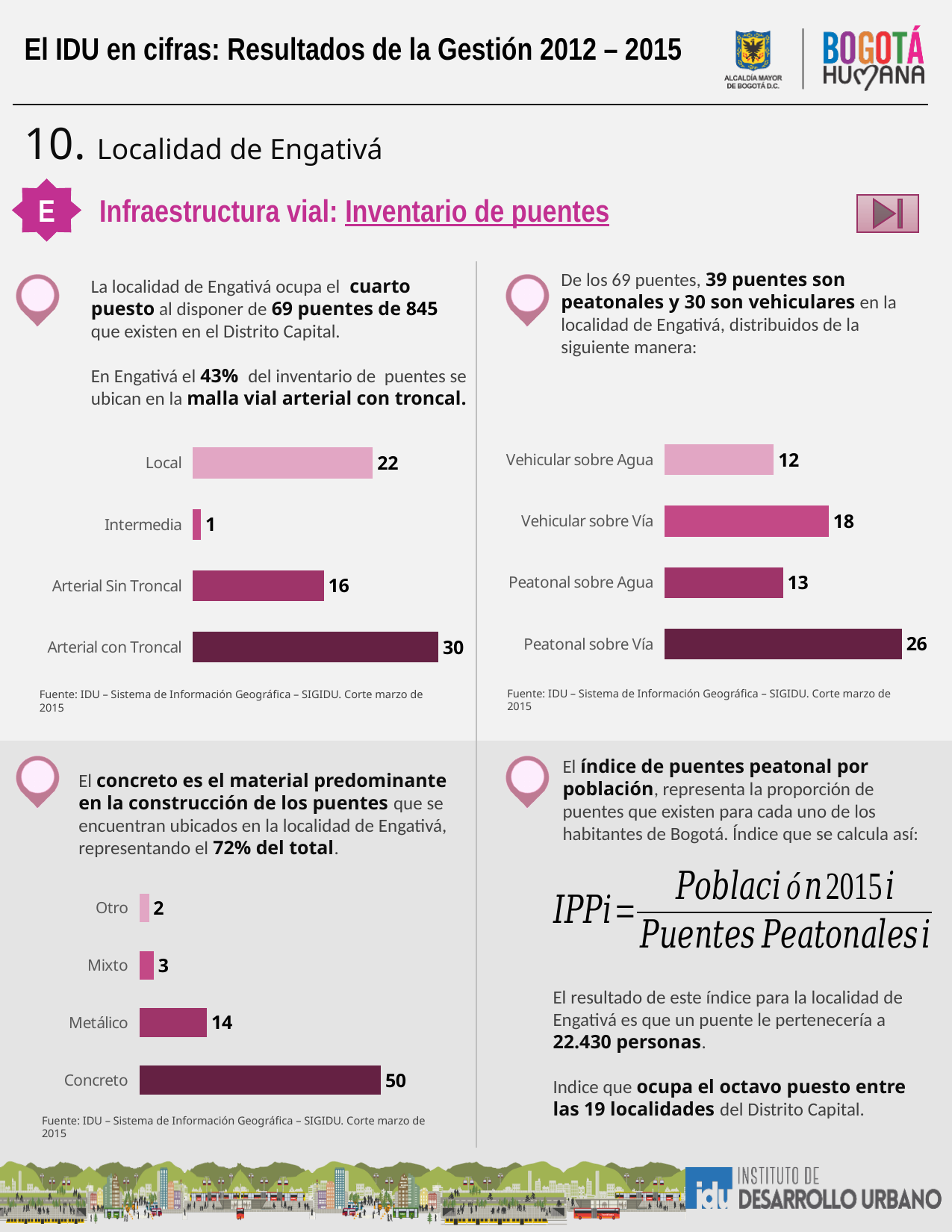
In the top-left bar chart, which category has the lowest value? Intermedia In the bottom-left bar chart, which category has the highest value? Concreto In the top-left bar chart, what is the value for Arterial con Troncal? 30 In the top-right bar chart, what is the difference between Peatonal sobre Vía and Vehicular sobre Agua? 14 How many categories does the top-left bar chart show? 4 In the bottom-left bar chart, what is the difference between Concreto and Mixto? 47 In the top-right bar chart, which is larger: Vehicular sobre Agua or Peatonal sobre Agua? Peatonal sobre Agua In the bottom-left bar chart, what is the value for Metálico? 14 What type of chart is the bottom-left chart? Bar chart In the top-right bar chart, what is the value for Vehicular sobre Vía? 18 In the top-left bar chart, what is the difference between Local and Arterial Sin Troncal? 6 In the top-right bar chart, which category has the highest value? Peatonal sobre Vía